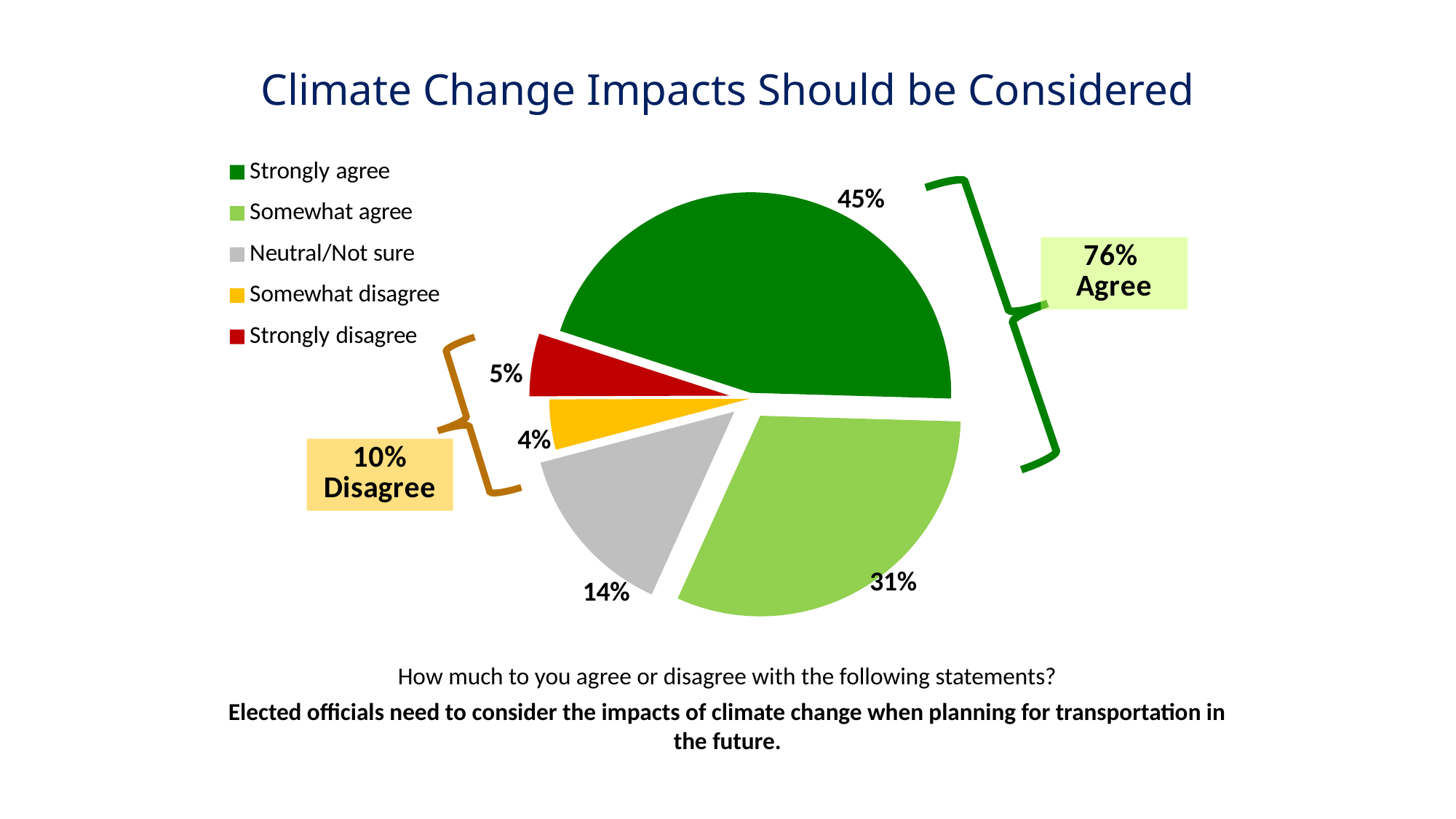
What percentage of respondents strongly agree? 45% Which is larger, the Neutral/Not sure share or the Strongly disagree share? Neutral/Not sure Which response category has the largest share of the pie? Strongly agree What percentage of respondents somewhat agree? 31% How many categories does the legend list? 5 What is the difference in percentage points between Strongly agree and Somewhat agree? 14 What kind of chart is shown on the slide? pie chart Which response category has the smallest share of the pie? Somewhat disagree What percentage of respondents strongly disagree? 5% What percentage of respondents are Neutral/Not sure? 14% What percentage of respondents somewhat disagree? 4% What is the title of the chart? Climate Change Impacts Should be Considered